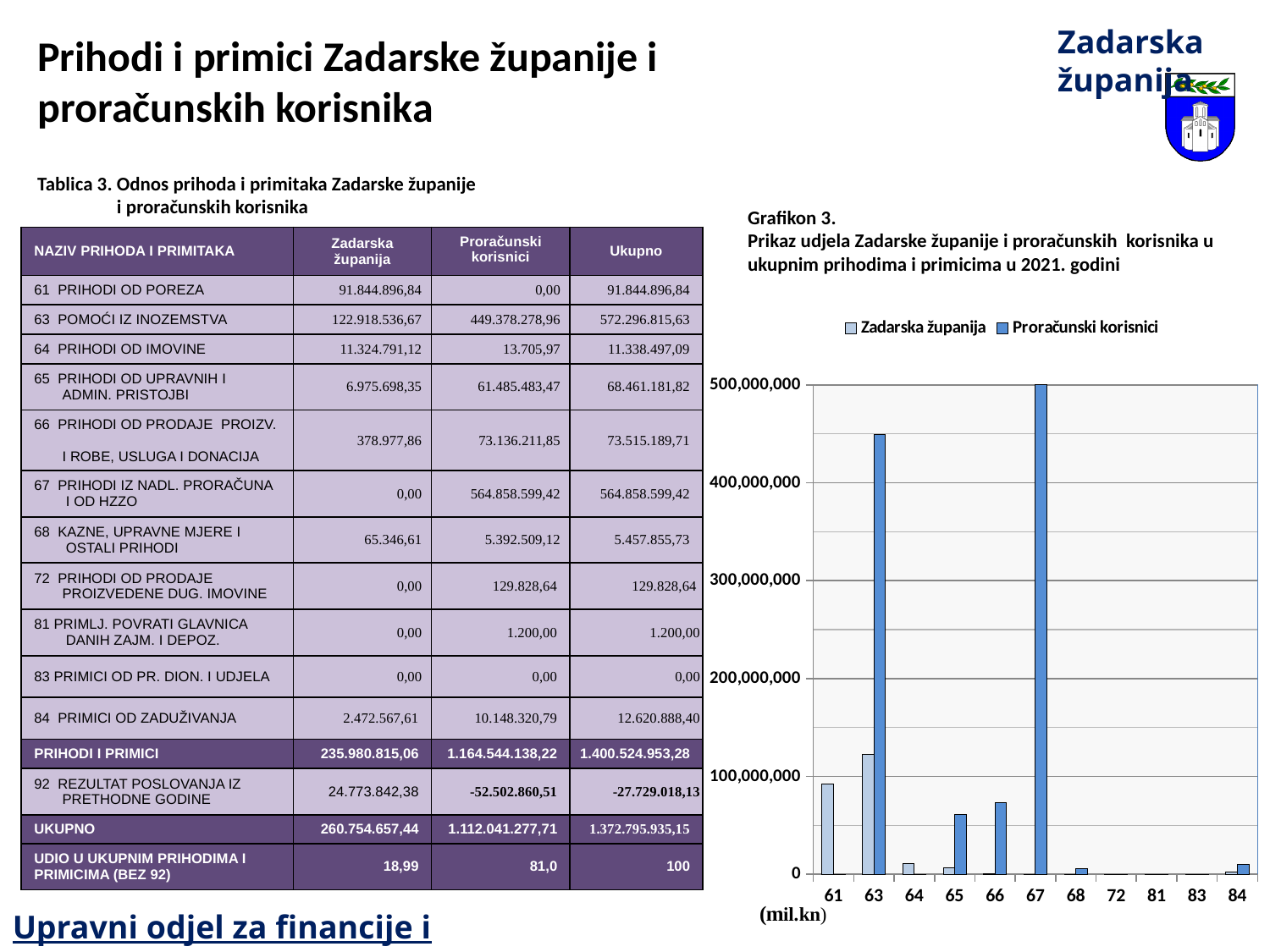
For category 63, which series has the larger value: Zadarska županija or Proračunski korisnici? Proračunski korisnici For category 61, which series has the larger value: Zadarska županija or Proračunski korisnici? Zadarska županija How many categories are shown along the x axis of the chart? 11 Is the Proračunski korisnici value for category 63 greater or less than 400,000,000? greater For which category is the Zadarska županija bar the highest? 63 Is the Proračunski korisnici value for category 66 greater or less than 100,000,000? less For which category is the Proračunski korisnici bar the highest? 67 How many series does the legend of the chart list? 2 Which year does the chart title say the data refers to? 2021 Is the Zadarska županija value for category 61 greater or less than 100,000,000? less What kind of chart is shown on the slide (Grafikon 3)? bar chart